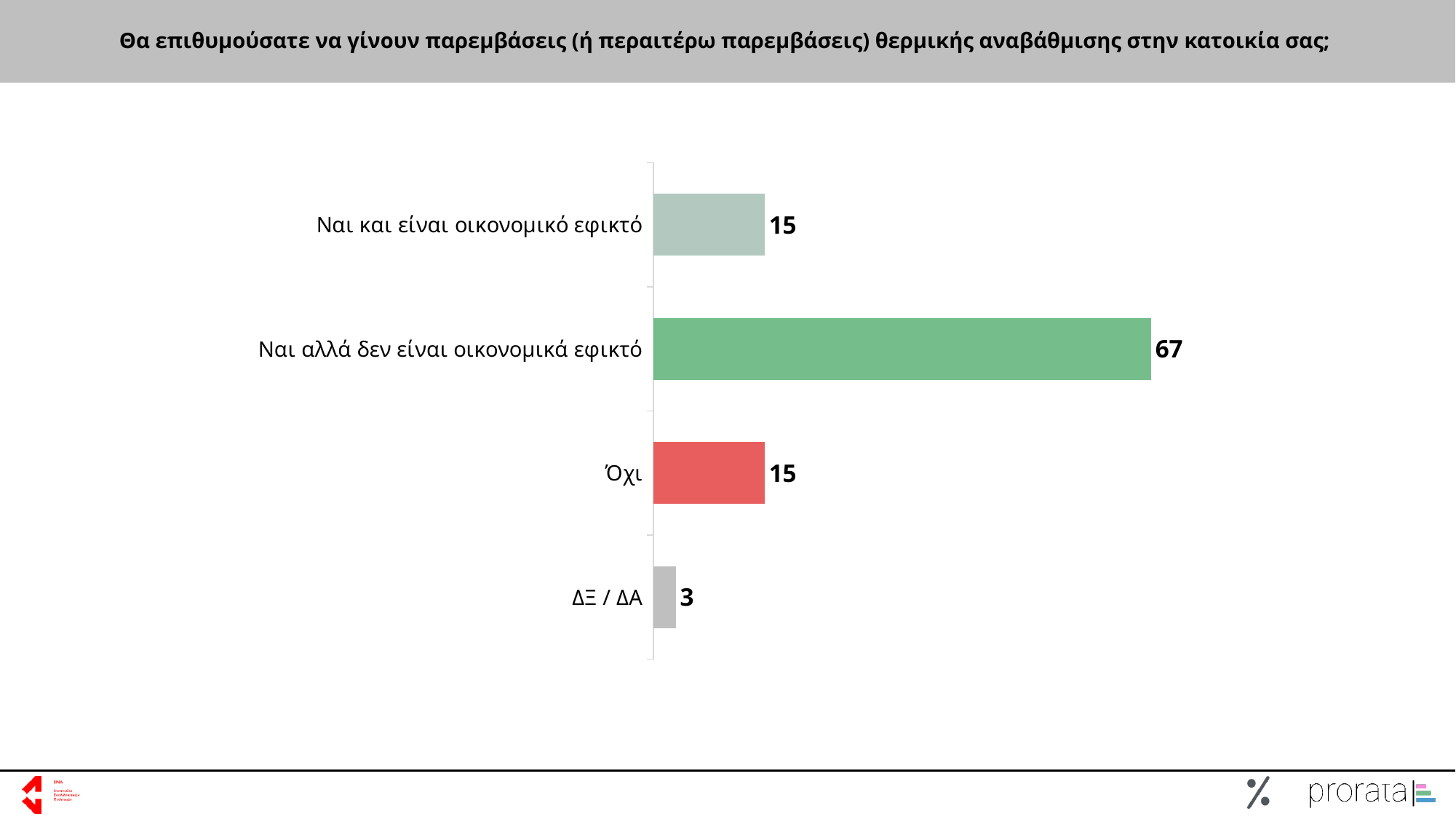
What is the difference between the values for "Ναι αλλά δεν είναι οικονομικά εφικτό" and "Όχι"? 52 Which is larger, the value for "Ναι αλλά δεν είναι οικονομικά εφικτό" or the value for "Ναι και είναι οικονομικό εφικτό"? Ναι αλλά δεν είναι οικονομικά εφικτό Which category has the highest value? Ναι αλλά δεν είναι οικονομικά εφικτό What is the value for "ΔΞ / ΔΑ"? 3 How many categories are shown in the chart? 4 What colour is the bar for "Όχι"? Red What is the value for "Ναι και είναι οικονομικό εφικτό"? 15 Which category has the lowest value? ΔΞ / ΔΑ What kind of chart is shown on the slide? Bar chart What is the value for "Ναι αλλά δεν είναι οικονομικά εφικτό"? 67 What is the value for "Όχι"? 15 What is the difference between the values for "Όχι" and "ΔΞ / ΔΑ"? 12